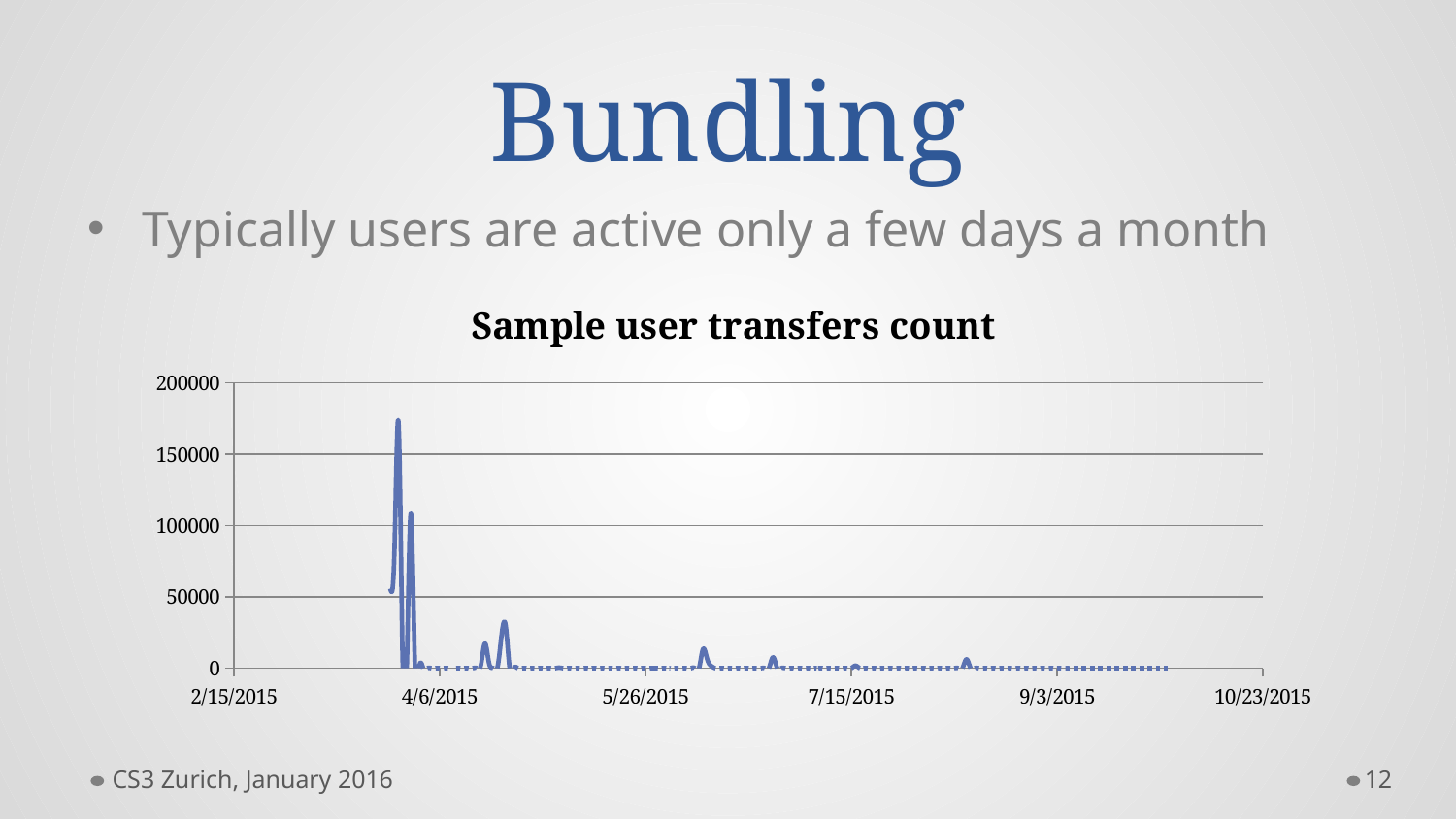
Which date label appears last on the horizontal axis? 10/23/2015 What is the highest value shown on the vertical axis? 200000 Which date label appears first on the horizontal axis? 2/15/2015 Do the values generally rise or fall along the x axis after the highest peak near 4/6/2015? fall Is the value of the peak shortly after 4/6/2015 greater or less than 50000? less What is the title of the chart? Sample user transfers count Is the value of the peak near 4/6/2015 that follows the highest peak greater or less than 150000? less How many date labels are shown on the horizontal axis? 6 Is the highest peak of the line greater or less than 150000? greater Does the highest peak of the line occur before or after 4/6/2015? before What kind of chart is shown on the slide? line chart